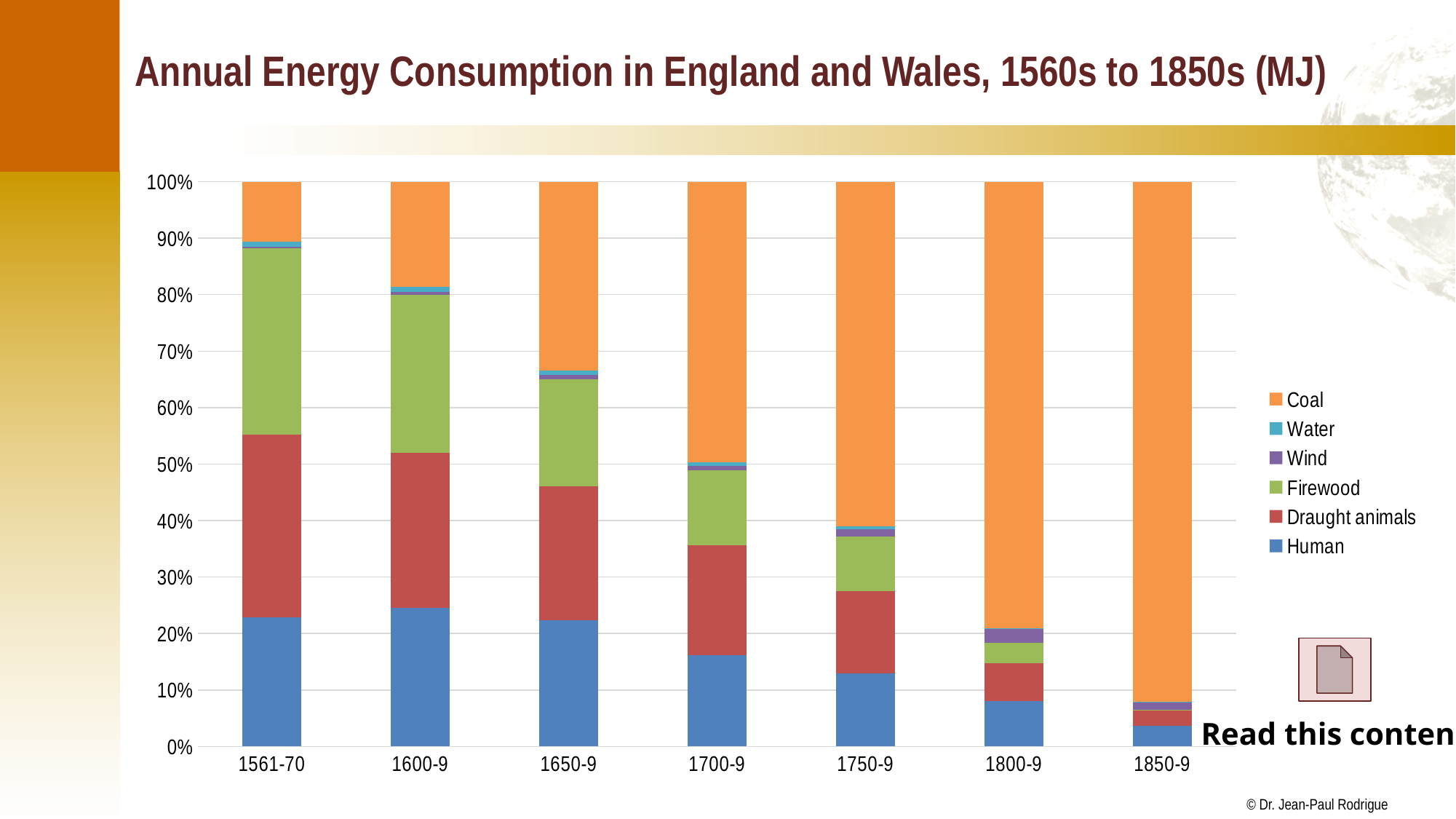
Which period has the larger Firewood share, 1561-70 or 1750-9? 1561-70 What kind of chart is shown on the slide? Stacked bar chart Is the Human share in 1800-9 greater or less than 10%? less Which period has the smallest share of Human energy? 1850-9 Does the share of Coal rise or fall from 1561-70 to 1850-9? Rise Which period has the smallest share of Coal? 1561-70 Is the Human share in 1561-70 greater or less than 20%? greater How many time periods are shown on the x axis? 7 How many series does the legend list? 6 Which period has the largest share of Coal? 1850-9 What is the title of the chart? Annual Energy Consumption in England and Wales, 1560s to 1850s (MJ) Which energy source is shown in orange in the legend? Coal